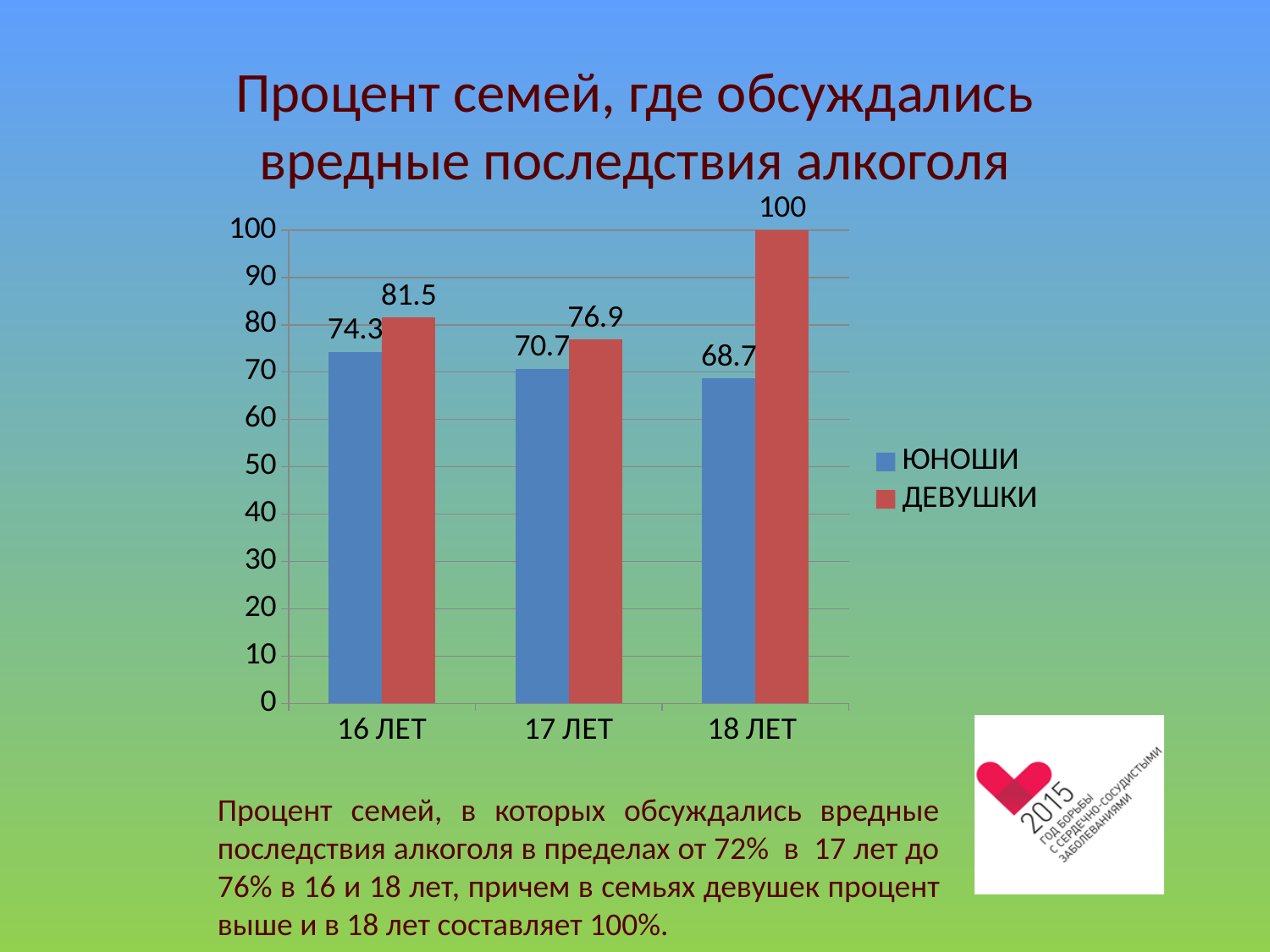
What colour are the bars for ДЕВУШКИ? red Which age group has the highest value for ДЕВУШКИ? 18 ЛЕТ What is the value for ДЕВУШКИ at 18 ЛЕТ? 100 Which age group has the lowest value for ЮНОШИ? 18 ЛЕТ What is the difference between ДЕВУШКИ and ЮНОШИ at 18 ЛЕТ? 31.3 Which is larger at 16 ЛЕТ: ЮНОШИ or ДЕВУШКИ? ДЕВУШКИ What is the value for ЮНОШИ at 16 ЛЕТ? 74.3 What is the value for ДЕВУШКИ at 17 ЛЕТ? 76.9 What kind of chart is shown on the slide? bar chart Do the values for ЮНОШИ rise or fall from 16 ЛЕТ to 18 ЛЕТ? fall How many series does the legend list? 2 How many age categories are shown on the x axis? 3